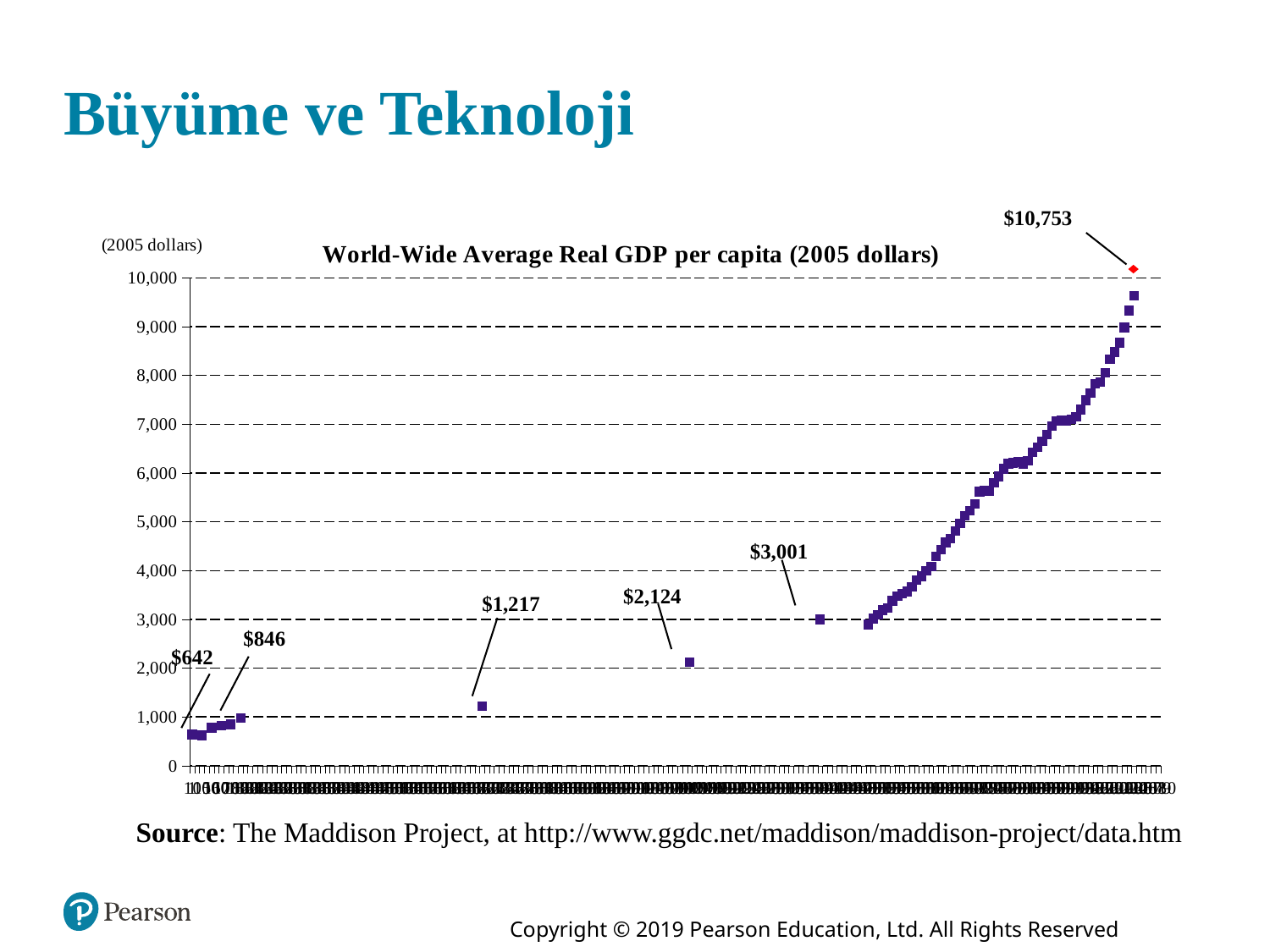
What is the highest value labeled on the chart? $10,753 Is the point labeled $3,001 greater or less than 4,000? less What is the difference between the labeled values $1,217 and $846? $371 Do the values generally rise or fall moving from left to right along the x axis? rise What kind of chart is shown on the slide? scatter chart What is the difference between the highest labeled value ($10,753) and the lowest labeled value ($642)? $10,111 Is the final (rightmost, red) point greater or less than 10,000? greater Which labeled value is larger, $2,124 or $1,217? $2,124 What is the difference between the labeled values $3,001 and $2,124? $877 What is the title of the chart? World-Wide Average Real GDP per capita (2005 dollars) What unit is stated in the label above the y axis? (2005 dollars) What is the lowest value labeled on the chart? $642